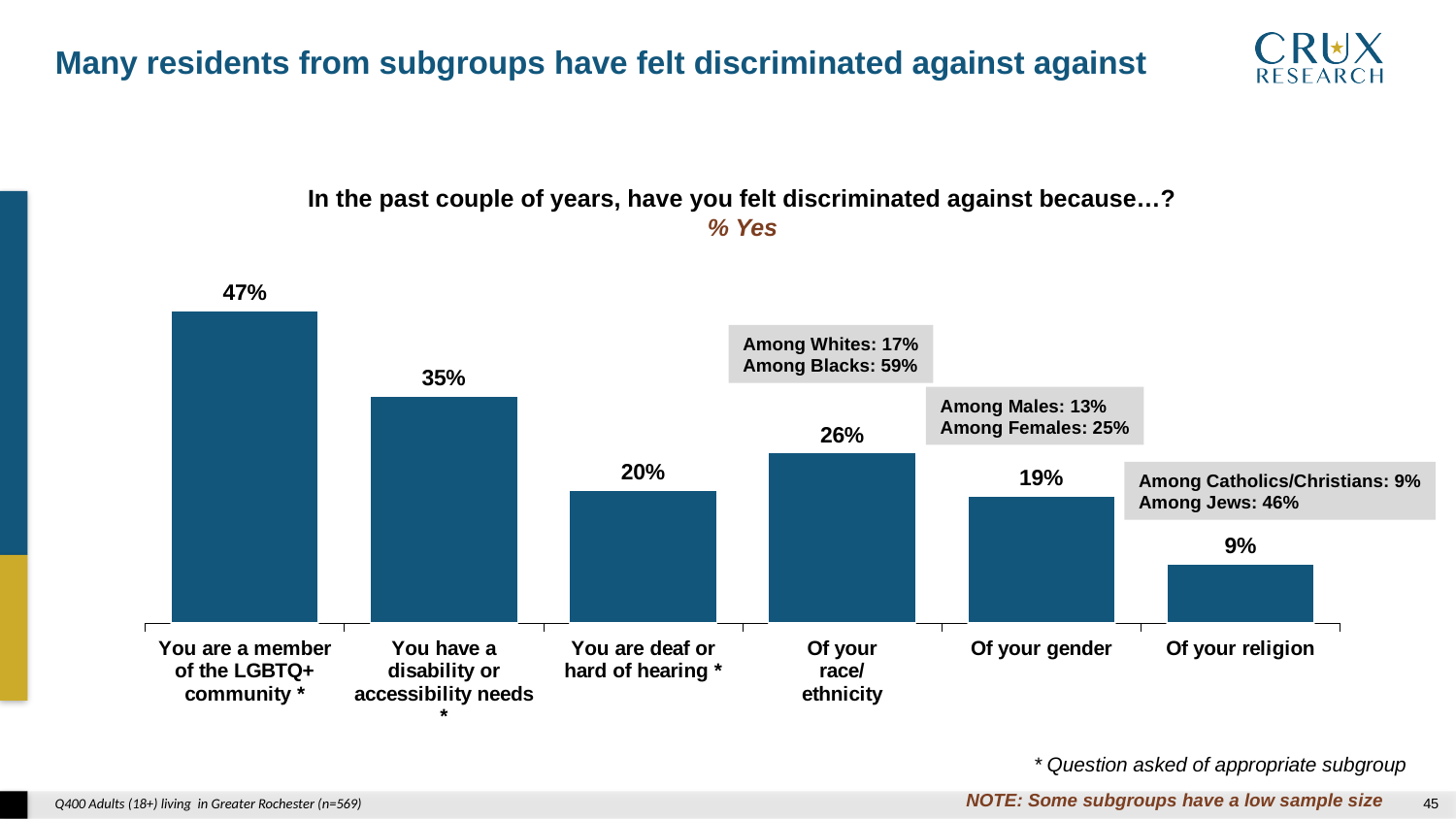
How many categories are shown in the chart? 6 What is the difference between the value for 'You have a disability or accessibility needs' and the value for 'Of your race/ethnicity'? 9% What kind of chart is shown on the slide? Bar chart What is the subtitle shown under the chart's question title? % Yes Which category has the highest percentage? You are a member of the LGBTQ+ community According to the annotation, what percentage of Blacks said they felt discriminated against because of their race/ethnicity? 59% What is the value for 'You are deaf or hard of hearing'? 20% Which category has the lowest percentage? Of your religion Which is larger: the value for 'Of your race/ethnicity' or the value for 'Of your gender'? Of your race/ethnicity What percentage of respondents said they felt discriminated against because they are a member of the LGBTQ+ community? 47% What is the value for 'Of your gender'? 19%